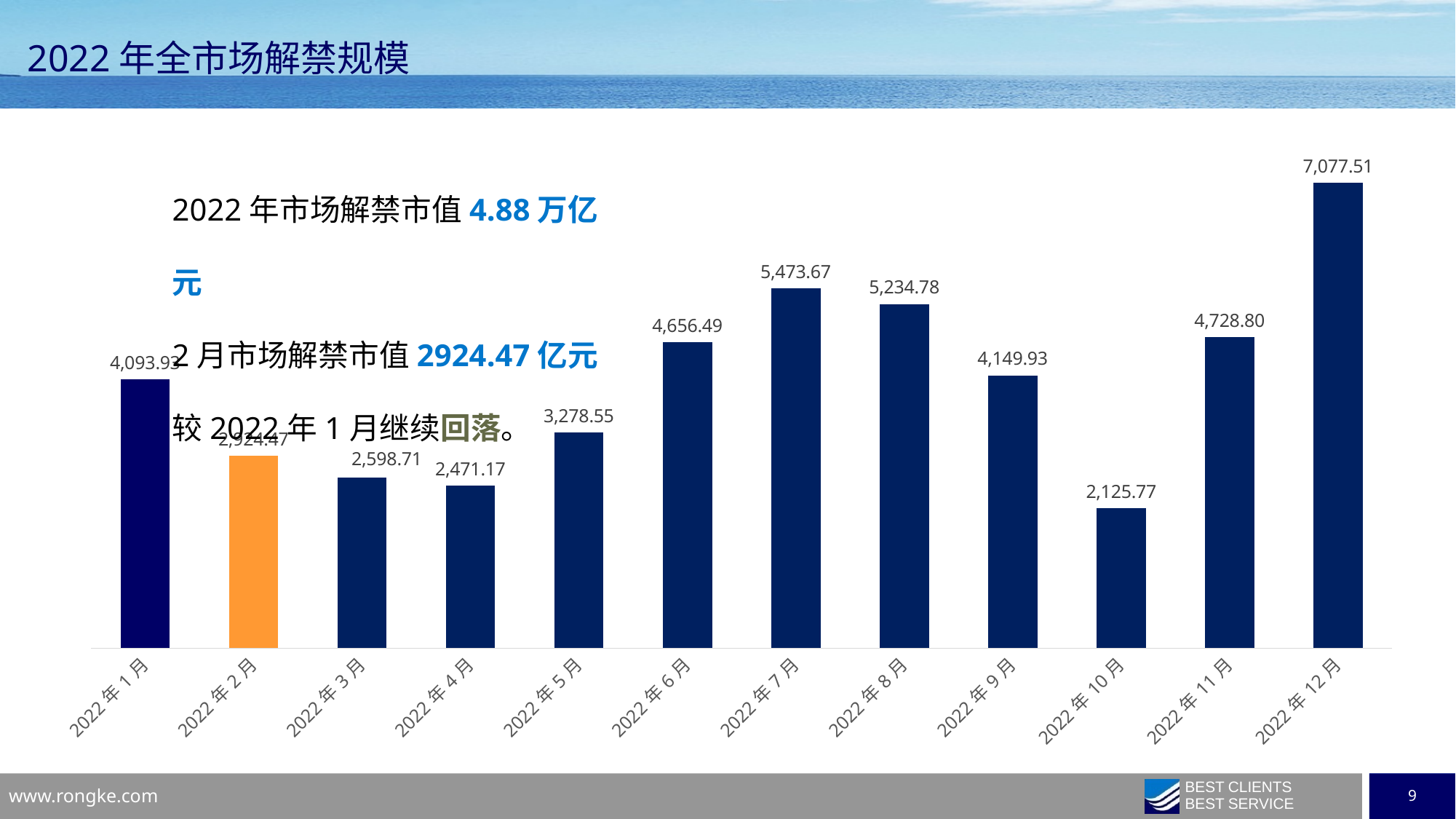
What is the value for 2022年10月? 2,125.77 Which month has the highest value? 2022年12月 Do the values rise or fall from 2022年4月 to 2022年7月? rise What is the value for 2022年12月? 7,077.51 What kind of chart is shown on the slide? bar chart What is the value for 2022年7月? 5,473.67 What is the value for 2022年5月? 3,278.55 What is the difference between the values for 2022年7月 and 2022年8月? 238.89 How many months are shown on the chart? 12 Which month has the lowest value? 2022年10月 What is the difference between the values for 2022年12月 and 2022年10月? 4,951.74 Which is larger, the value for 2022年6月 or 2022年11月? 2022年11月